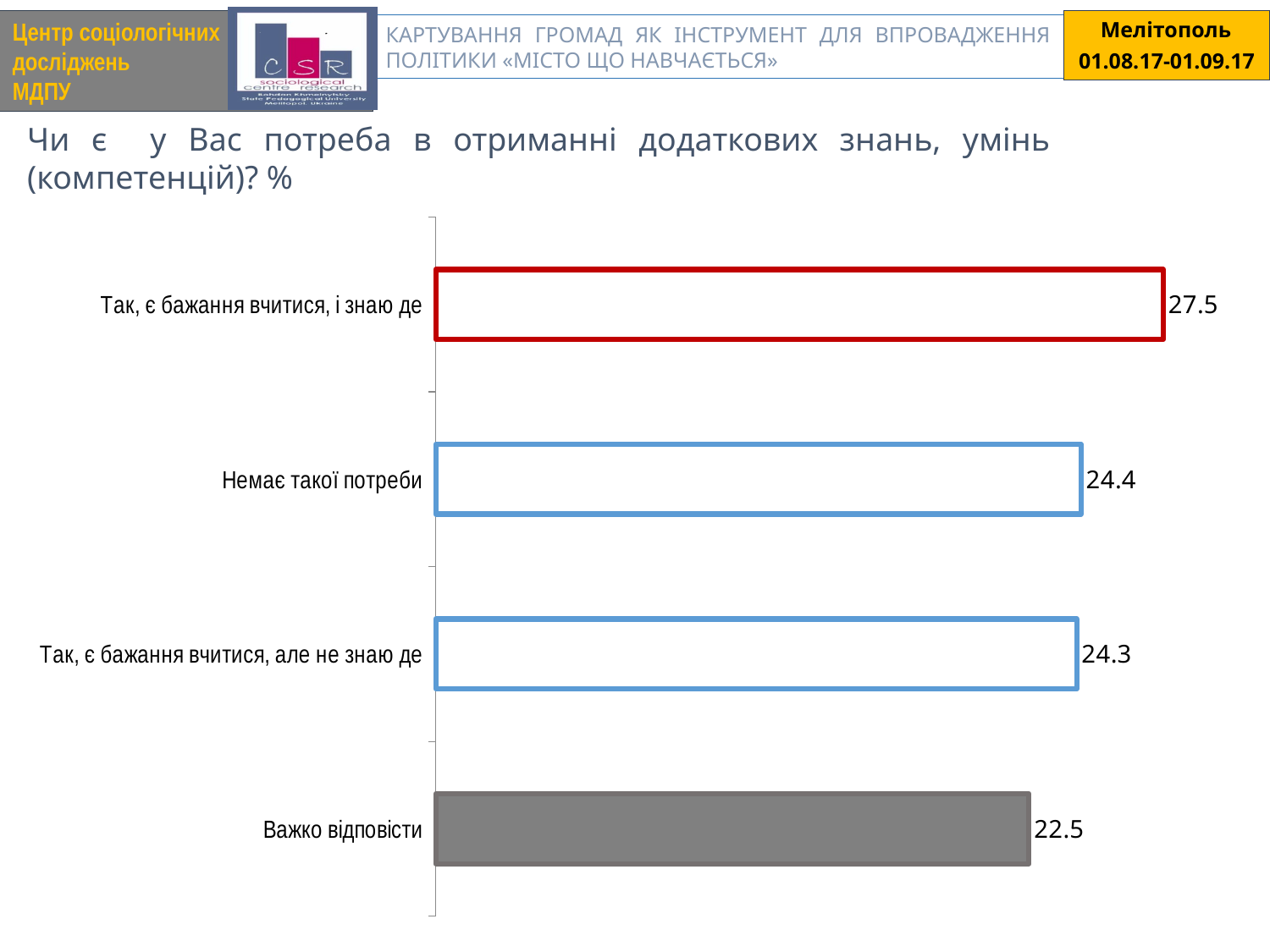
What is the value for "Важко відповісти"? 22.5 What is the difference between the values for "Так, є бажання вчитися, і знаю де" and "Важко відповісти"? 5.0 What is the value for "Так, є бажання вчитися, і знаю де"? 27.5 What kind of chart is shown on the slide? Bar chart What is the value for "Так, є бажання вчитися, але не знаю де"? 24.3 Which bar is outlined in red? Так, є бажання вчитися, і знаю де Which category has the lowest value? Важко відповісти How many categories are shown in the chart? 4 What is the difference between the values for "Немає такої потреби" and "Важко відповісти"? 1.9 Which category has the highest value? Так, є бажання вчитися, і знаю де What is the value for "Немає такої потреби"? 24.4 Which is larger: the value for "Так, є бажання вчитися, і знаю де" or the value for "Важко відповісти"? Так, є бажання вчитися, і знаю де